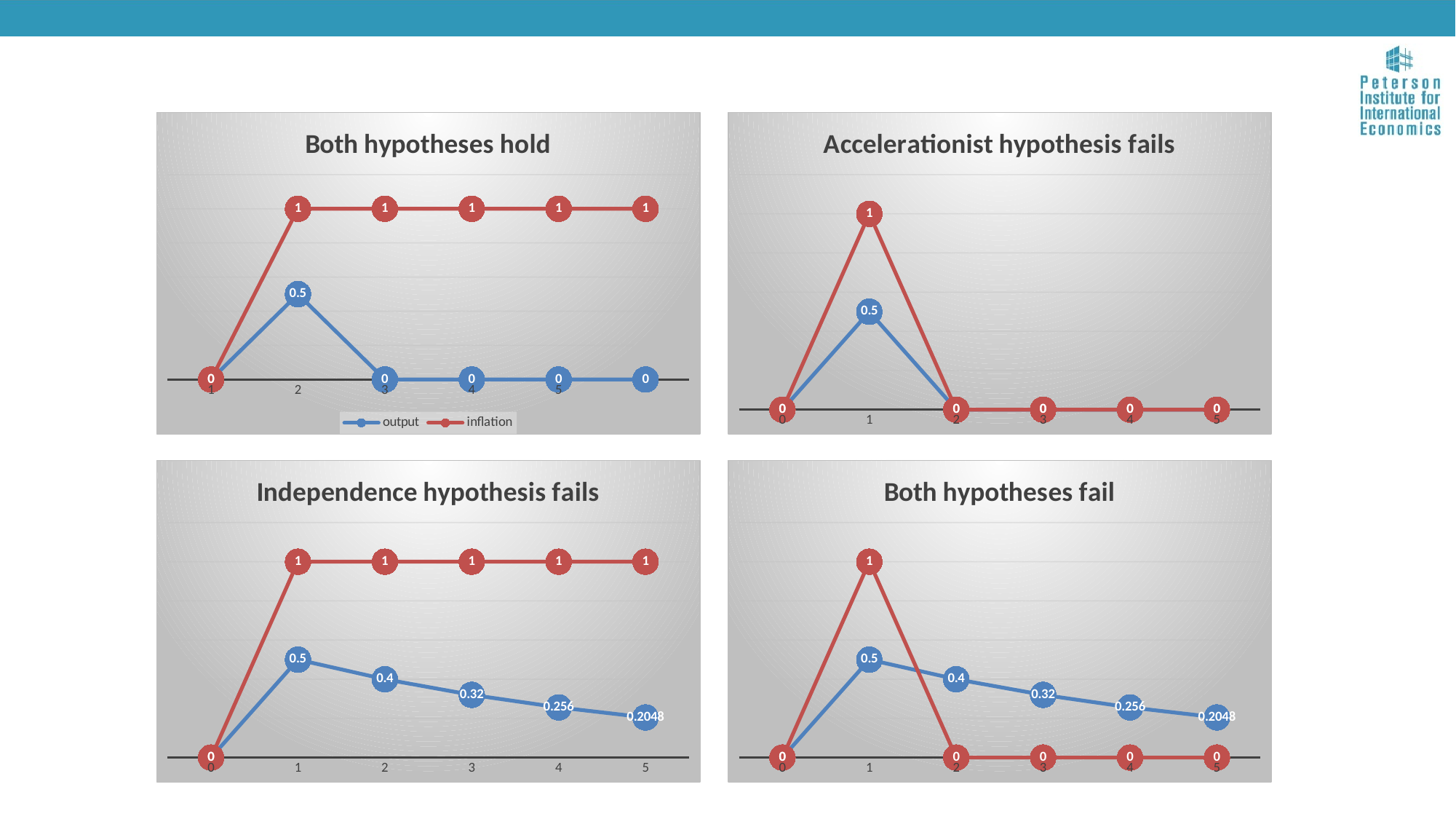
In the 'Both hypotheses fail' chart, which series has the larger value at x = 2, output or inflation? output In the 'Both hypotheses hold' chart, which colour is used for the inflation series? red How many series does the legend in the 'Both hypotheses hold' chart list? 2 What kind of chart is the 'Both hypotheses fail' chart? line chart In the 'Independence hypothesis fails' chart, what is the output value at x = 5? 0.2048 In the 'Both hypotheses fail' chart, at which x value does inflation reach its highest value? 1 In the 'Independence hypothesis fails' chart, what is the difference between the output values at x = 1 and x = 2? 0.1 In the 'Both hypotheses fail' chart, what is the output value at x = 3? 0.32 In the 'Independence hypothesis fails' chart, does the output series rise or fall from x = 1 to x = 5? fall How many data points does each series have in the 'Accelerationist hypothesis fails' chart? 6 In the 'Accelerationist hypothesis fails' chart, what is the inflation value at x = 1? 1 In the 'Both hypotheses hold' chart, what is the inflation value at the last point? 1